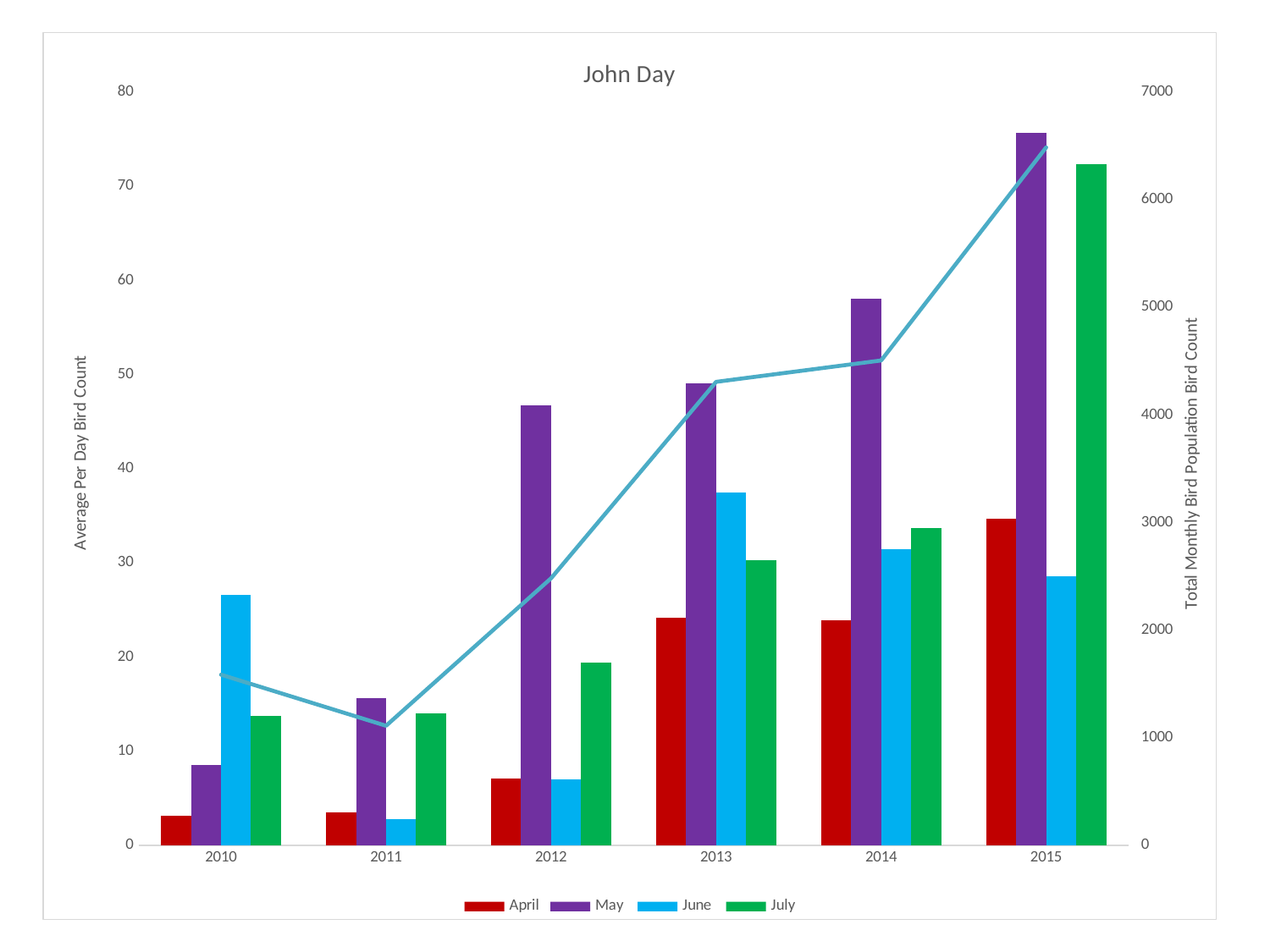
What is the title of the chart? John Day How many years are shown on the x axis? 6 Does the line plotted on the right axis rise or fall from 2011 to 2015? rises In 2013, which is larger, the June bar or the July bar? June Is the value for May in 2012 greater or less than 40? greater Which year has the highest June bar? 2013 How many series does the legend list? 4 Which year has the highest May bar? 2015 Is the value for April in 2015 greater or less than 30? greater In 2010, which is larger, the May bar or the June bar? June What kind of chart is this? Bar chart with a line Is the value for June in 2010 greater or less than 30? less